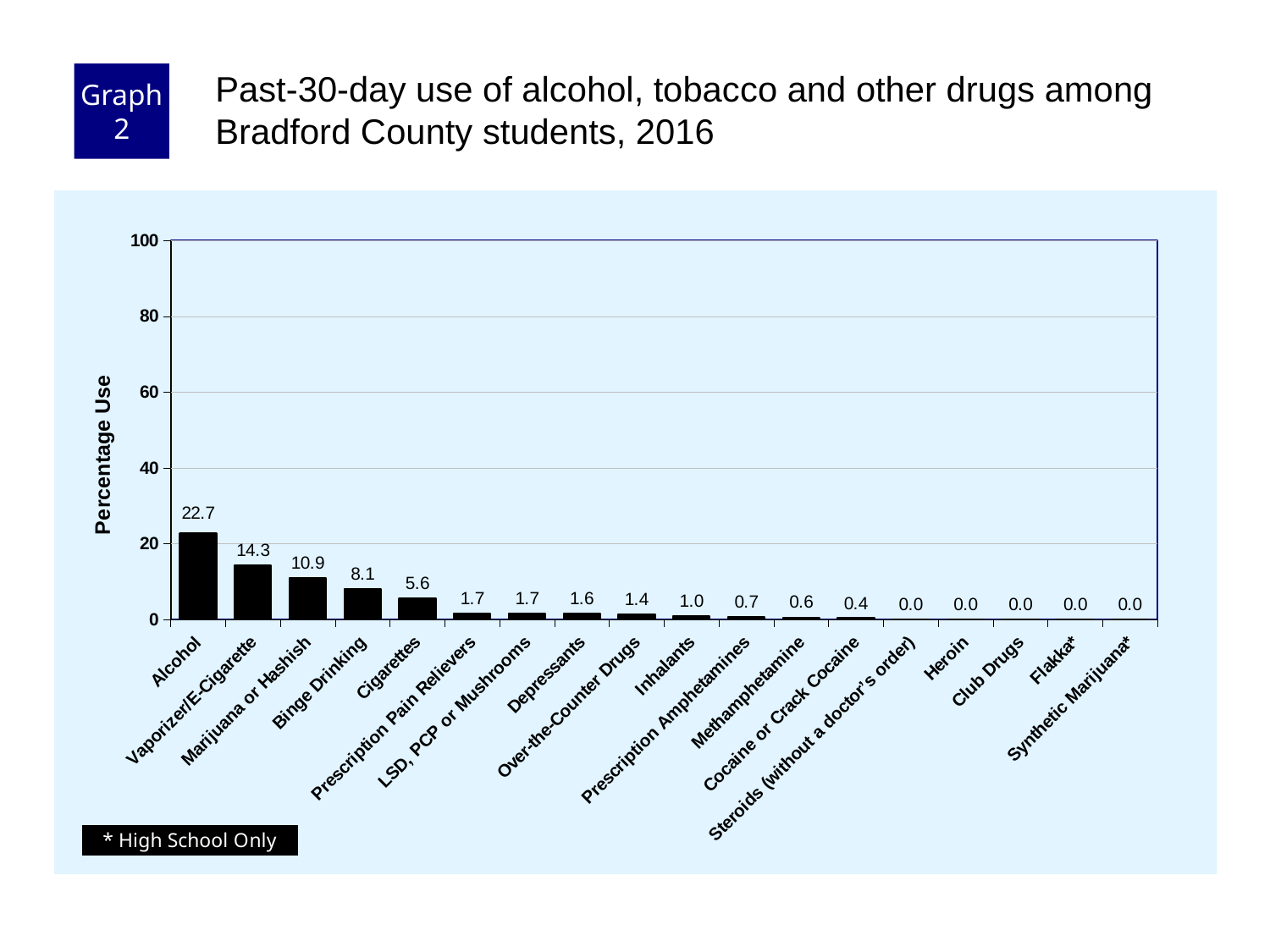
What is the value shown for Binge Drinking? 8.1 What is the label of the y axis? Percentage Use What kind of chart is shown on the slide? Bar chart What is the value shown for Cocaine or Crack Cocaine? 0.4 What is the difference between the values for Cigarettes and Inhalants? 4.6 Which category has the highest percentage use? Alcohol What is the value shown for Vaporizer/E-Cigarette? 14.3 What is the difference between the values for Alcohol and Marijuana or Hashish? 11.8 Which is larger, the value for Depressants or the value for Methamphetamine? Depressants Is the value for Alcohol greater or less than 20? greater What is the past-30-day use percentage for Alcohol? 22.7 How many categories are shown on the x axis? 18